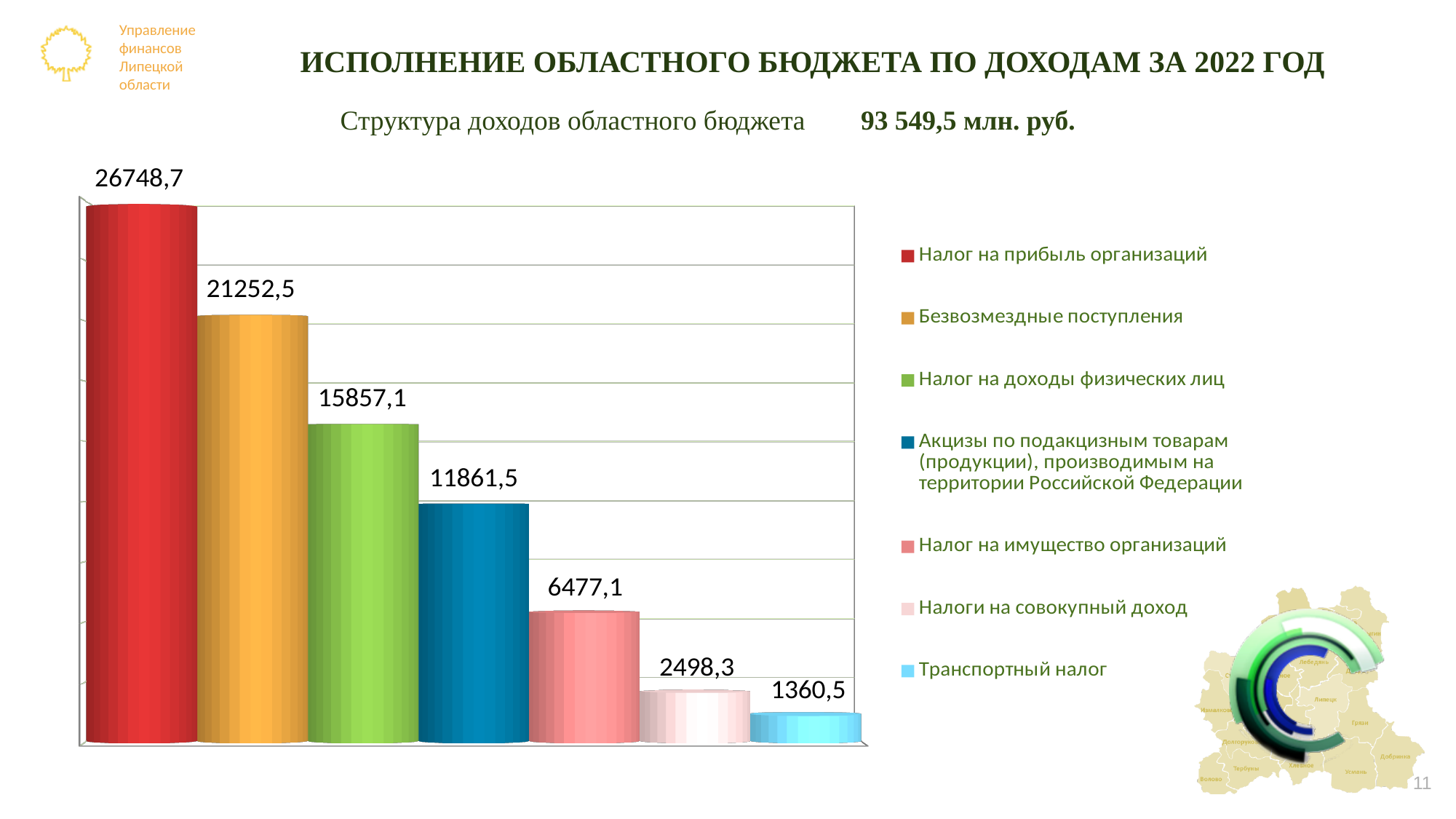
Which category has the highest value? Налог на прибыль организаций What kind of chart is shown on the slide? Bar chart Which is larger: Налог на имущество организаций or Акцизы по подакцизным товарам? Акцизы по подакцизным товарам What is the value for Налог на доходы физических лиц? 15857,1 What is the value for Безвозмездные поступления? 21252,5 What total amount is stated next to the chart subtitle 'Структура доходов областного бюджета'? 93 549,5 млн. руб. What is the difference between Налог на прибыль организаций and Безвозмездные поступления? 5496,2 Which category has the lowest value? Транспортный налог How many bars are shown in the chart? 7 What is the value for Налог на прибыль организаций? 26748,7 What is the value for Транспортный налог? 1360,5 What is the difference between Налоги на совокупный доход and Транспортный налог? 1137,8